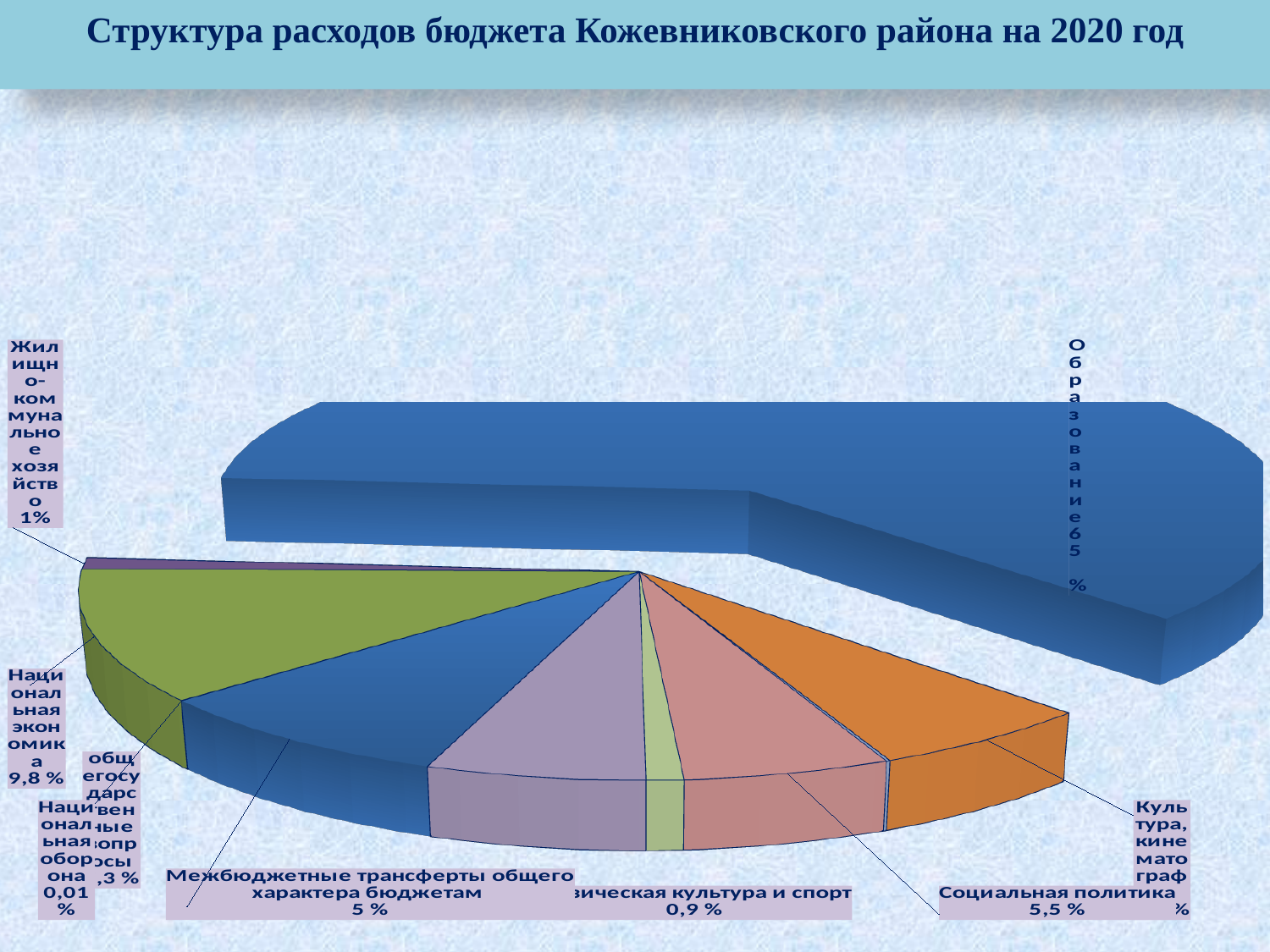
By how many percentage points does the share for Национальная экономика exceed the share for Социальная политика? 4,3 % Which is larger: the share for Социальная политика or the share for Межбюджетные трансферты общего характера бюджетам? Социальная политика What is the title of the chart on the slide? Структура расходов бюджета Кожевниковского района на 2020 год Which category has the largest share of the budget expenditures? Образование What is the value shown for Жилищно-коммунальное хозяйство? 1% What kind of chart is shown on the slide? pie chart What share of the budget expenditures goes to Образование? 65% What is the value shown for Национальная оборона? 0,01 % What is the value shown for Национальная экономика? 9,8 % Which category has the smallest share of the budget expenditures? Национальная оборона What is the value shown for Межбюджетные трансферты общего характера бюджетам? 5 % What is the value shown for Социальная политика? 5,5 %